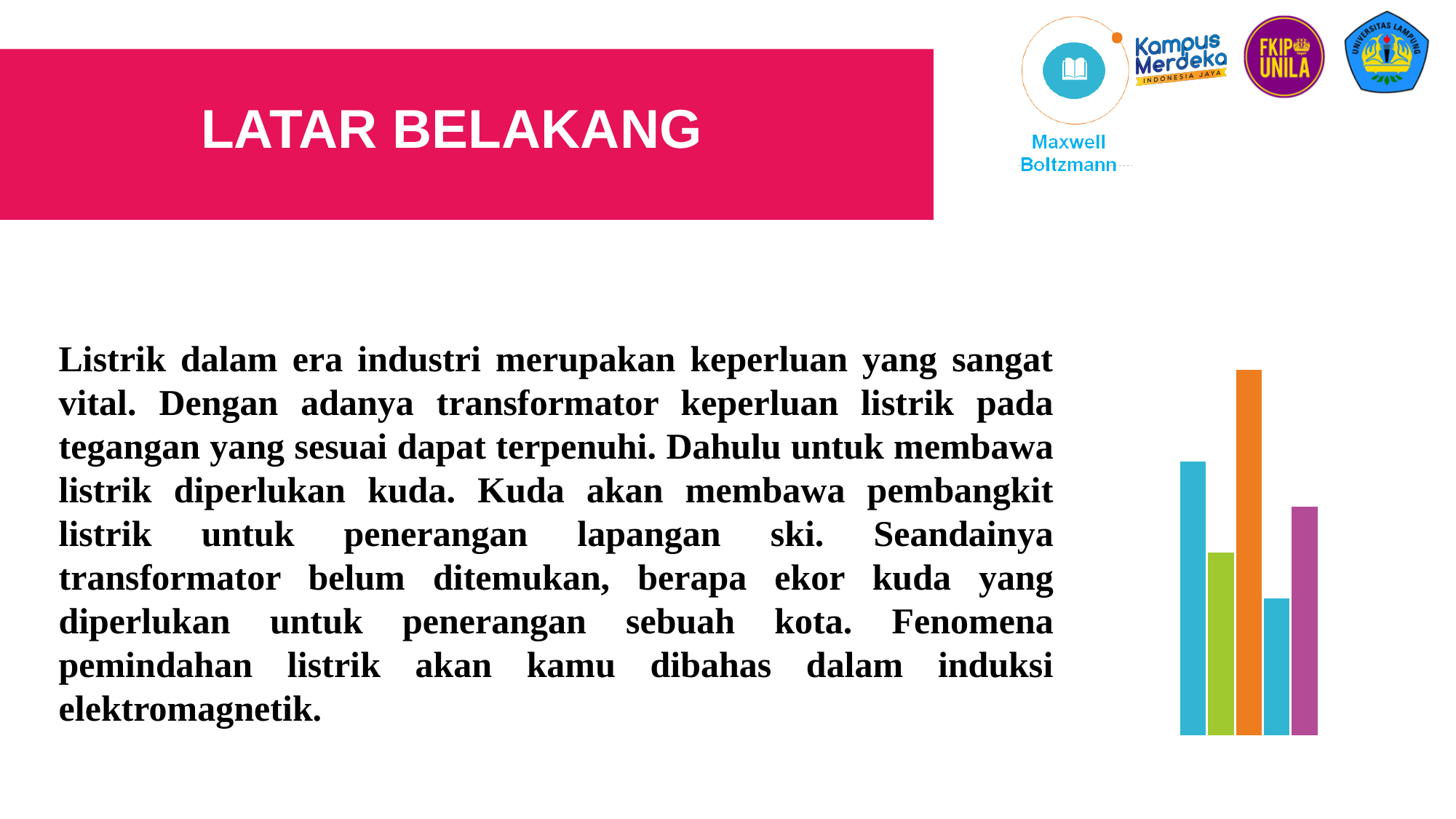
What colour is the tallest bar in the chart on the right? orange Which bar in the chart on the right is the shortest? the fourth (light blue) bar How many bars does the chart on the right side of the slide have? 5 In the chart on the right, is the fourth bar or the fifth bar taller? the fifth bar In the chart on the right, is the first bar or the fifth bar taller? the first bar Does the chart on the right show any axis labels or data labels? No In the chart on the right, is the first bar or the second bar taller? the first bar Which bar in the chart on the right is the tallest? the third (orange) bar What kind of chart is shown on the right side of the slide? bar chart